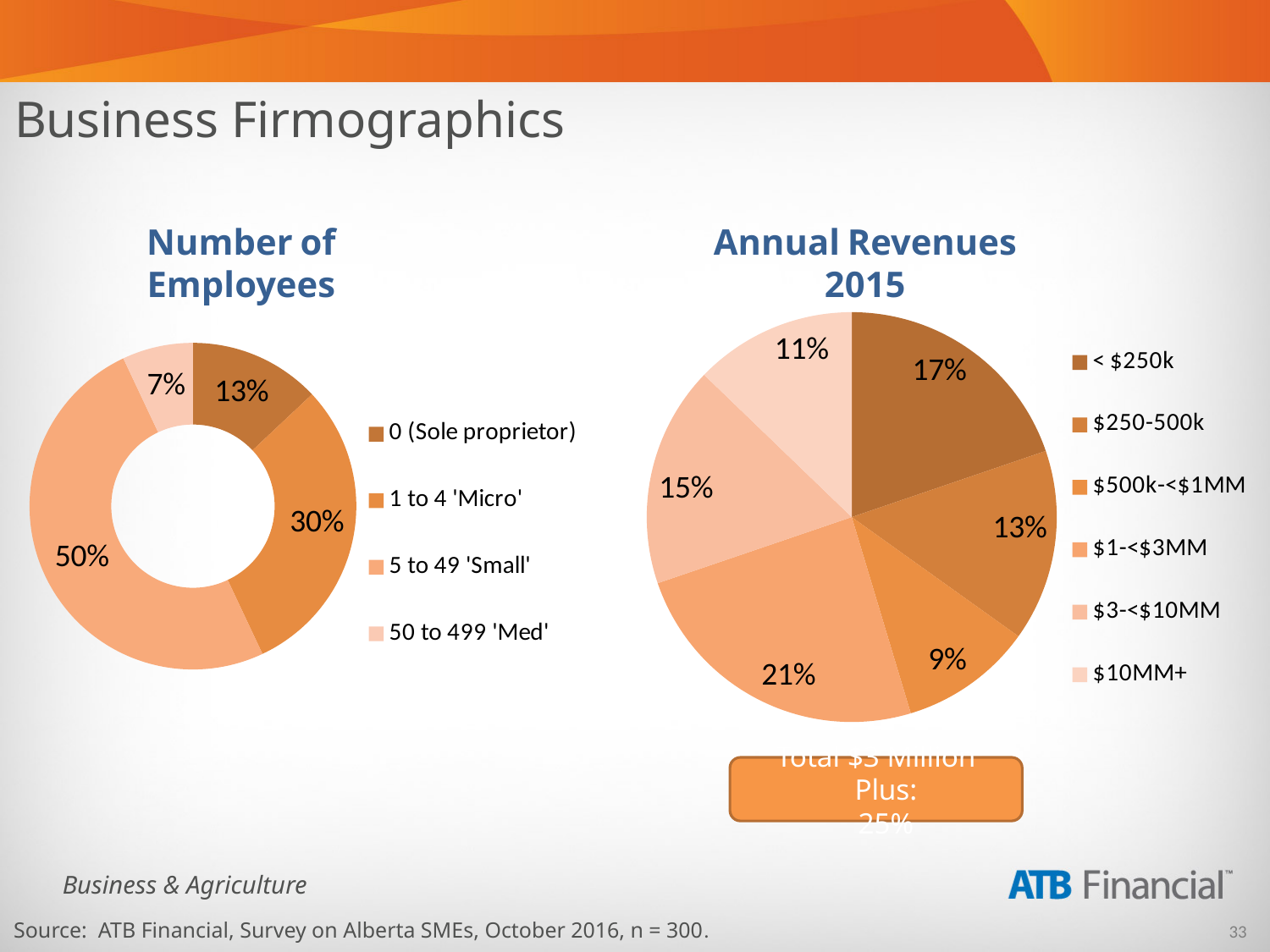
In the Number of Employees chart, which category has the smallest share? 50 to 499 'Med' What kind of chart is the Number of Employees chart? Doughnut chart In the Number of Employees chart, what is the difference between the 1 to 4 'Micro' share and the 50 to 499 'Med' share? 23% In the Annual Revenues 2015 chart, what percentage is shown for $10MM+? 11% In the Number of Employees chart, what percentage is shown for 0 (Sole proprietor)? 13% In the Number of Employees chart, what share of businesses have 5 to 49 'Small' employees? 50% In the Annual Revenues 2015 chart, which revenue category has the smallest share? $500k-<$1MM How many revenue categories does the legend of the Annual Revenues 2015 chart list? 6 In the Annual Revenues 2015 chart, which is larger: the share for < $250k or the share for $3-<$10MM? < $250k In the Annual Revenues 2015 chart, which revenue category has the largest share? $1-<$3MM How many categories does the Number of Employees chart show? 4 In the Annual Revenues 2015 chart, what percentage of businesses had revenues of $1-<$3MM? 21%